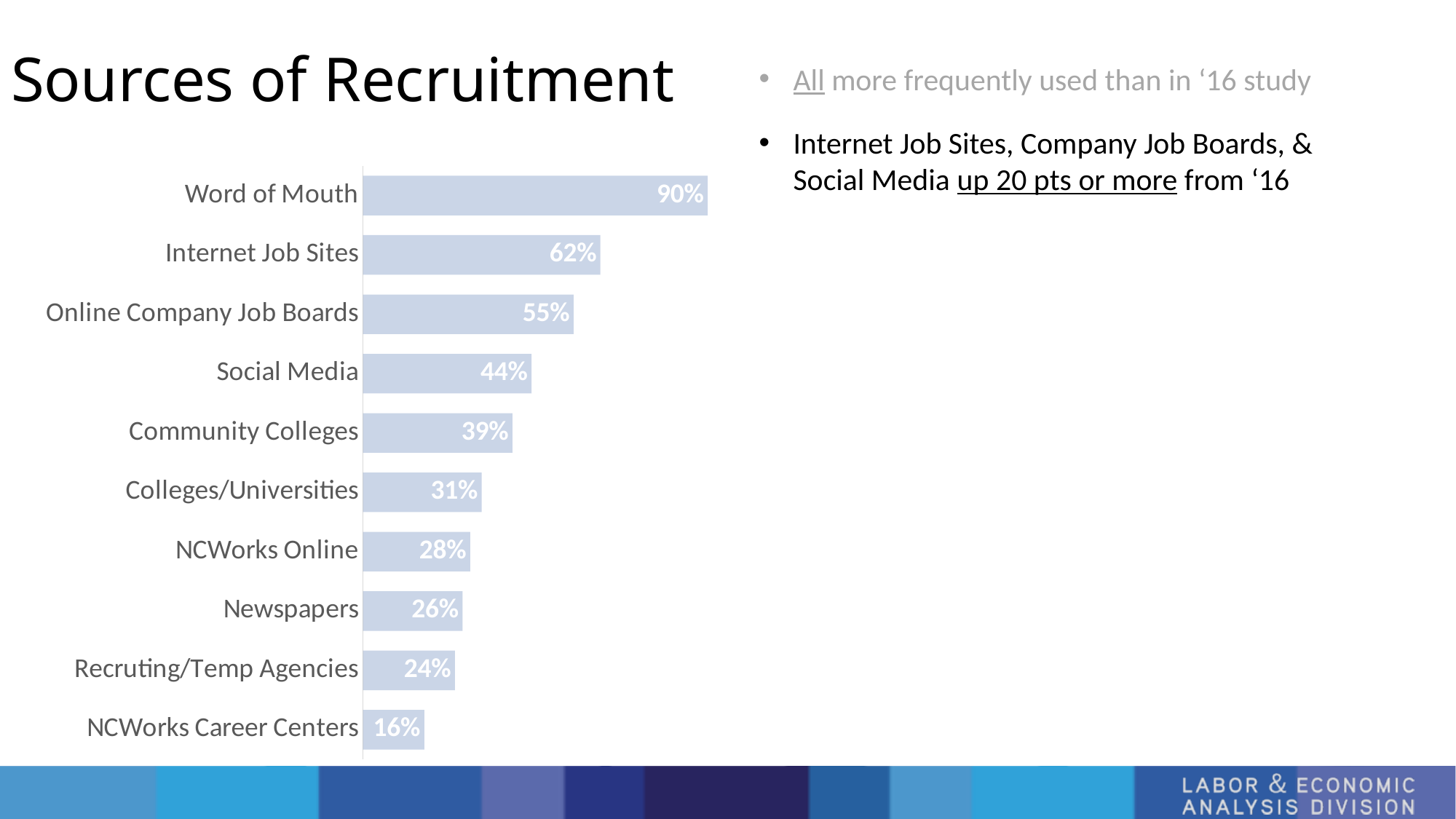
Which source of recruitment has the lowest value? NCWorks Career Centers What kind of chart is shown on the slide? Bar chart What is the title of the slide containing the chart? Sources of Recruitment Which is larger, Community Colleges or Colleges/Universities? Community Colleges What percentage is shown for NCWorks Online? 28% What is the value for Social Media? 44% How many sources of recruitment are shown in the chart? 10 Which is larger, Newspapers or Recruting/Temp Agencies? Newspapers Which source of recruitment has the highest value? Word of Mouth What is the difference between Internet Job Sites and Online Company Job Boards? 7% What percentage is shown for Word of Mouth? 90% What is the difference between Word of Mouth and NCWorks Career Centers? 74%